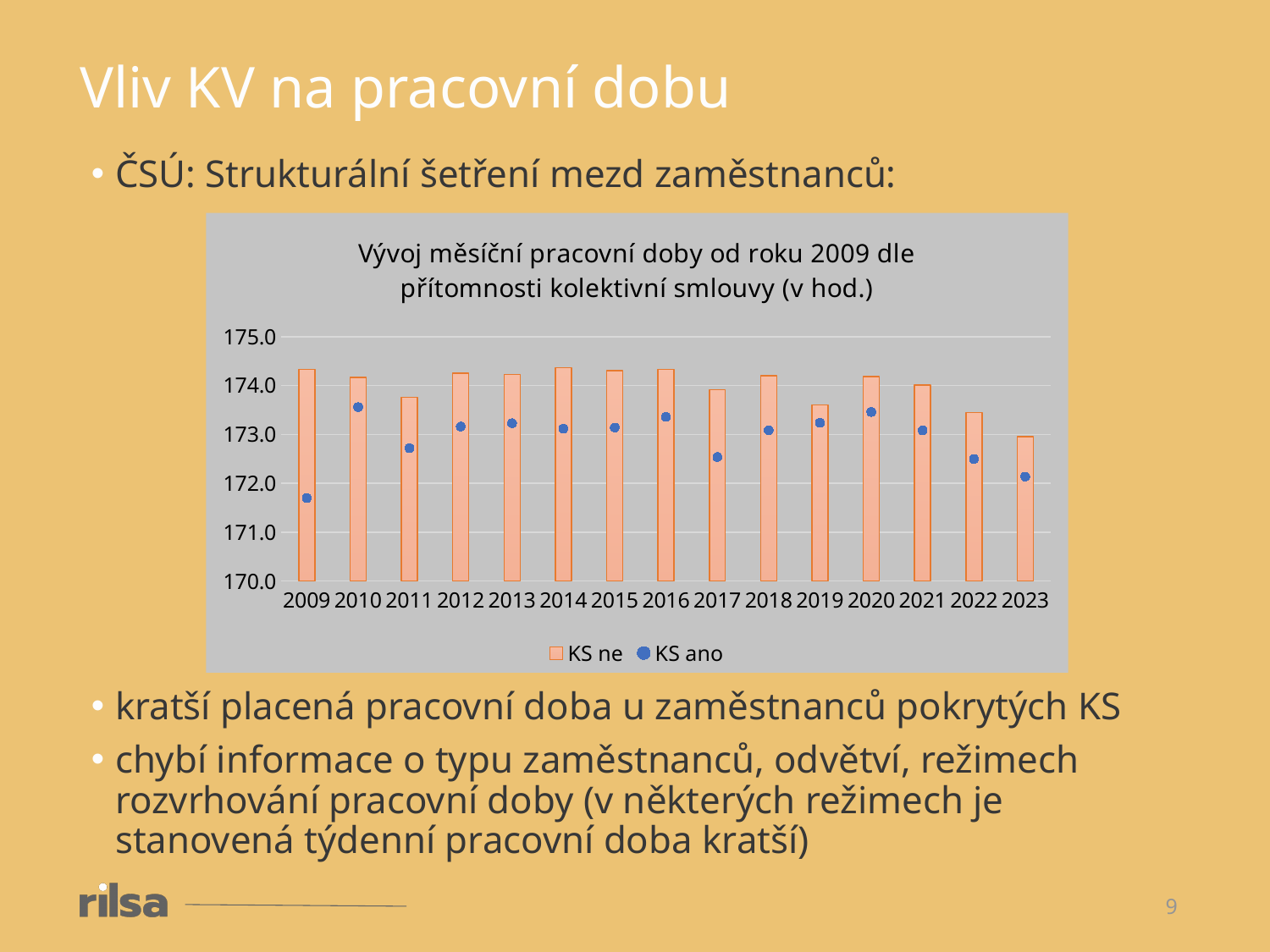
In 2009, which is larger: the KS ne value or the KS ano value? KS ne How many series does the chart legend list? 2 What kind of chart is used to show the KS ne series? bar chart Is the KS ne value for 2022 greater or less than 174.0? less Is the KS ano value for 2009 greater or less than 172.0? less In which year is the KS ano value the lowest? 2009 How many years are shown on the x axis of the chart? 15 Is the KS ne value for 2009 greater or less than 174.0? greater What are the two series named in the chart legend? KS ne and KS ano What is the title of the chart? Vývoj měsíční pracovní doby od roku 2009 dle přítomnosti kolektivní smlouvy (v hod.) In which year is the KS ne bar the lowest? 2023